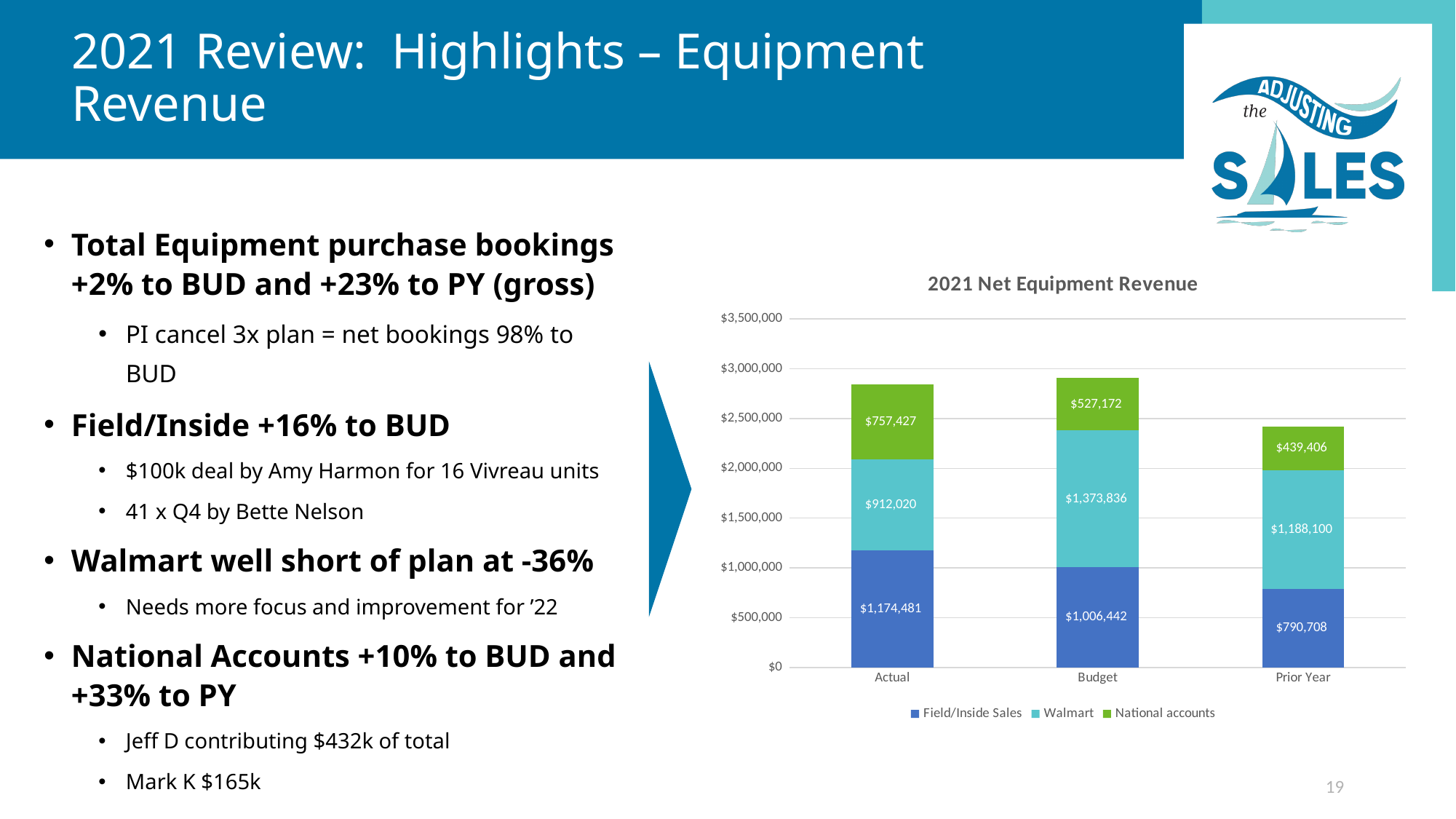
Which category has the highest Field/Inside Sales value? Actual Is the National accounts value for Actual or for Budget larger? Actual What is the Field/Inside Sales value for the Actual bar? $1,174,481 Which category has the lowest National accounts value? Prior Year How many series does the chart legend list? 3 How many categories are shown on the x axis of the chart? 3 What is the Walmart value for the Budget bar? $1,373,836 What is the total of the Actual stacked bar? $2,843,928 What type of chart is shown on the slide? Stacked bar chart What is the National accounts value for the Prior Year bar? $439,406 What is the title of the chart? 2021 Net Equipment Revenue What is the difference between the Walmart values for Budget and Actual? $461,816